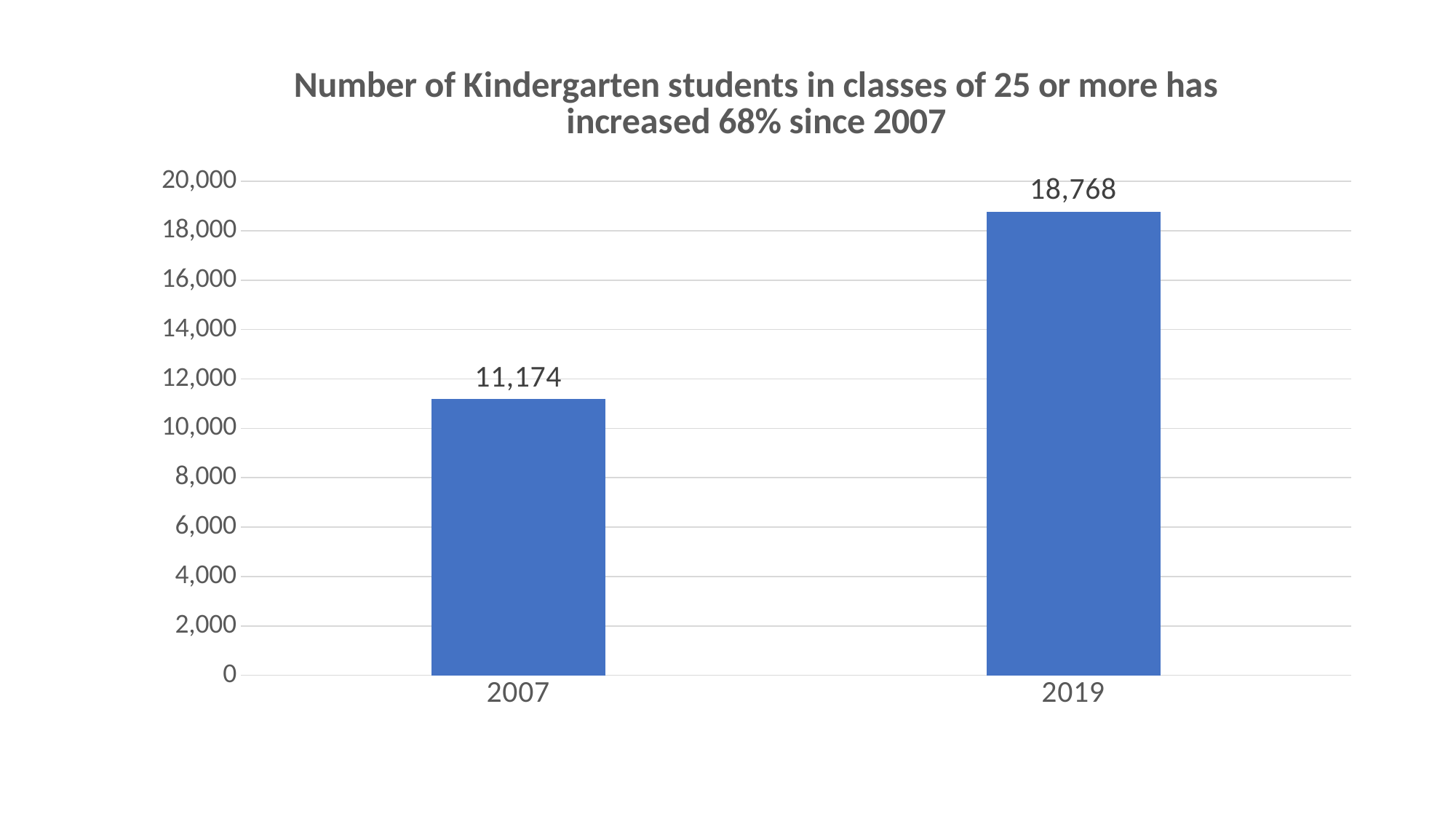
What kind of chart is shown on the slide? bar chart What is the value for 2007? 11,174 What is the value for 2019? 18,768 Which is larger, the value for 2007 or the value for 2019? 2019 What is the difference between the values for 2019 and 2007? 7,594 According to the chart title, by what percentage has the number of Kindergarten students in classes of 25 or more increased since 2007? 68% How many bars are shown in the chart? 2 Do the values rise or fall from 2007 to 2019? rise Is the value for 2007 greater or less than 12,000? less Is the value for 2019 greater or less than 18,000? greater Which year has the highest value? 2019 Which year has the lowest value? 2007